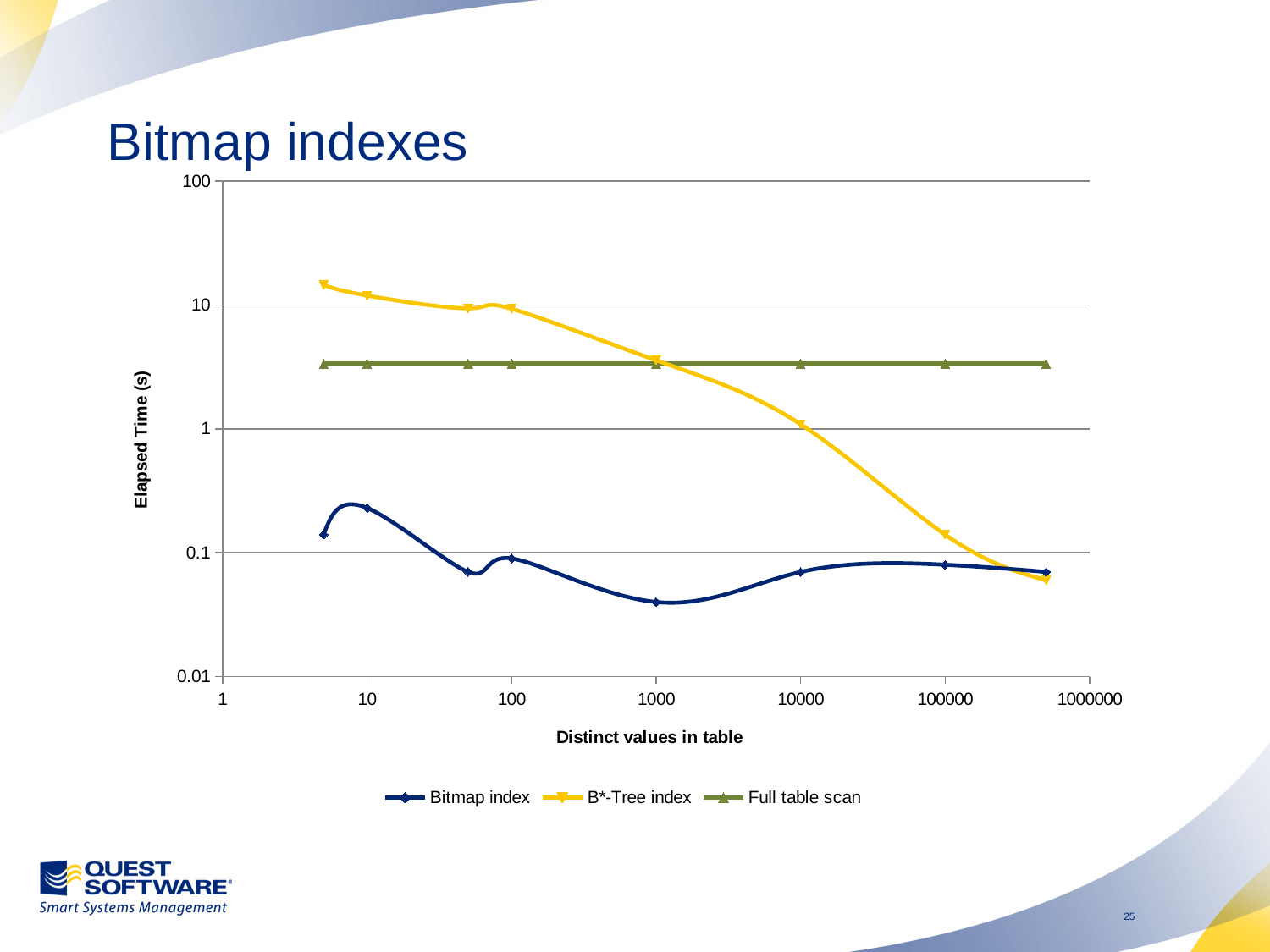
Is the value for B*-Tree index at 10 distinct values greater or less than 10? greater What is the label of the y axis? Elapsed Time (s) At 10 distinct values, which series has the larger elapsed time, B*-Tree index or Full table scan? B*-Tree index What kind of chart is shown on the slide? line chart What are the three series named in the legend? Bitmap index, B*-Tree index, Full table scan Is the value for B*-Tree index at 1000 distinct values greater or less than 10? less Is the value for Bitmap index at 1000 distinct values greater or less than 0.1? less How many series does the legend list? 3 Does the B*-Tree index elapsed time rise or fall as the number of distinct values increases? fall At 1000 distinct values, which series has the larger elapsed time, Bitmap index or B*-Tree index? B*-Tree index